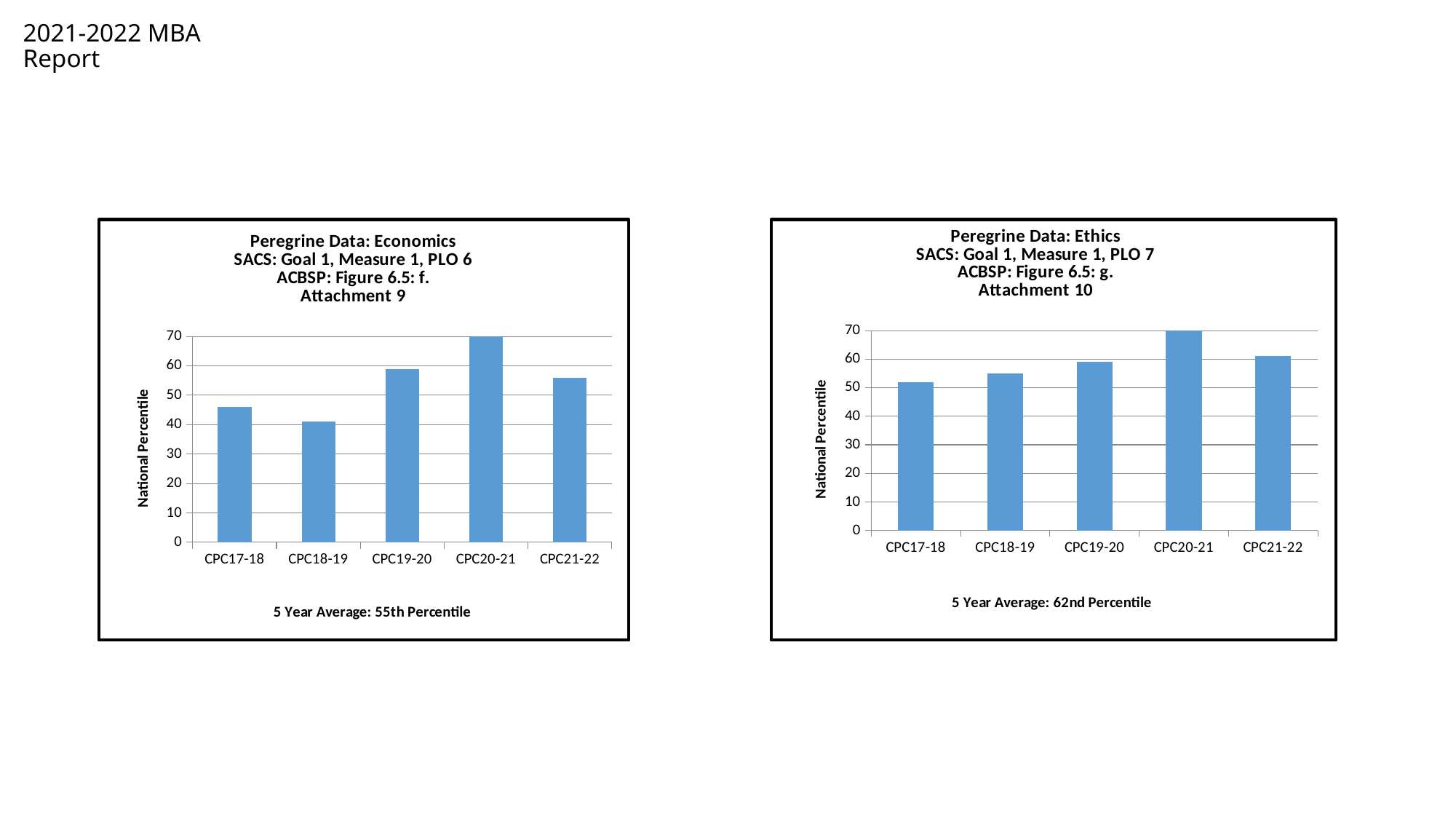
In the Peregrine Data: Ethics chart, is the value for CPC21-22 greater or less than 50? greater In the Peregrine Data: Economics chart, which category has the highest national percentile? CPC20-21 What type of chart is the Peregrine Data: Economics chart? bar chart In the Peregrine Data: Ethics chart, which category has the highest national percentile? CPC20-21 In the Peregrine Data: Economics chart, which category has the lowest national percentile? CPC18-19 In the Peregrine Data: Economics chart, is the value for CPC18-19 greater or less than 50? less How many categories are shown on the x axis of the Peregrine Data: Economics chart? 5 What 5 year average is stated below the Peregrine Data: Ethics chart? 62nd Percentile In the Peregrine Data: Ethics chart, which category has the lowest national percentile? CPC17-18 In the Peregrine Data: Economics chart, is the value for CPC19-20 greater or less than 50? greater